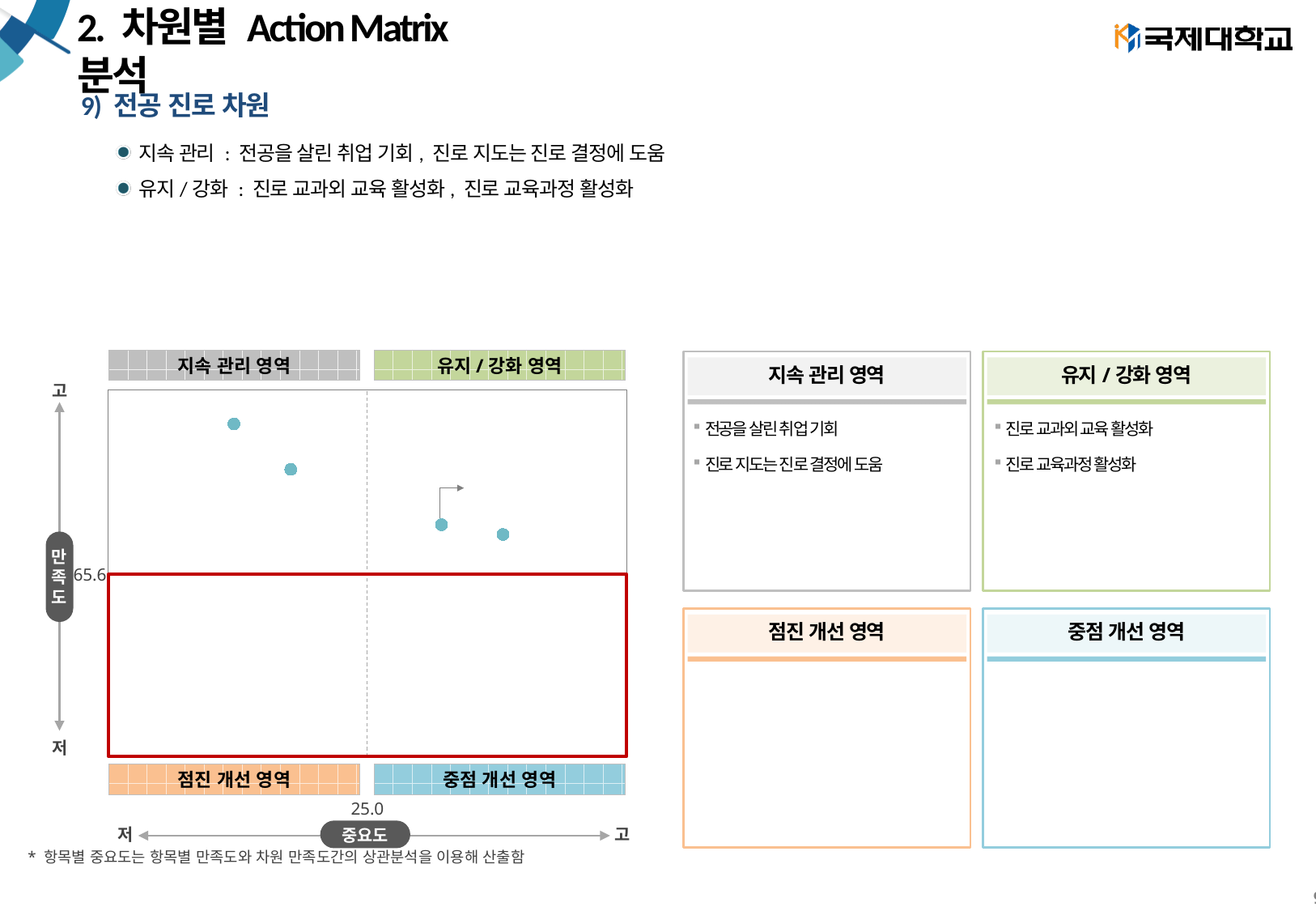
What value is marked on the vertical (만족도) axis as the horizontal dividing line of the matrix? 65.6 Which quadrant of the chart is outlined with a red border? the bottom half (점진 개선 영역 and 중점 개선 영역) How many data points fall in the 점진 개선 영역 (bottom-left) quadrant of the chart? 0 What kind of chart is shown on the left side of the slide? scatter chart How many data points fall in the 중점 개선 영역 (bottom-right) quadrant of the chart? 0 What is the label of the vertical axis of the chart? 만족도 What value is marked on the horizontal (중요도) axis as the vertical dividing line of the matrix? 25.0 How many data points fall in the 지속 관리 영역 (top-left) quadrant of the chart? 2 What is the label of the horizontal axis of the chart? 중요도 Are all plotted points above or below the 65.6 line on the 만족도 axis? above